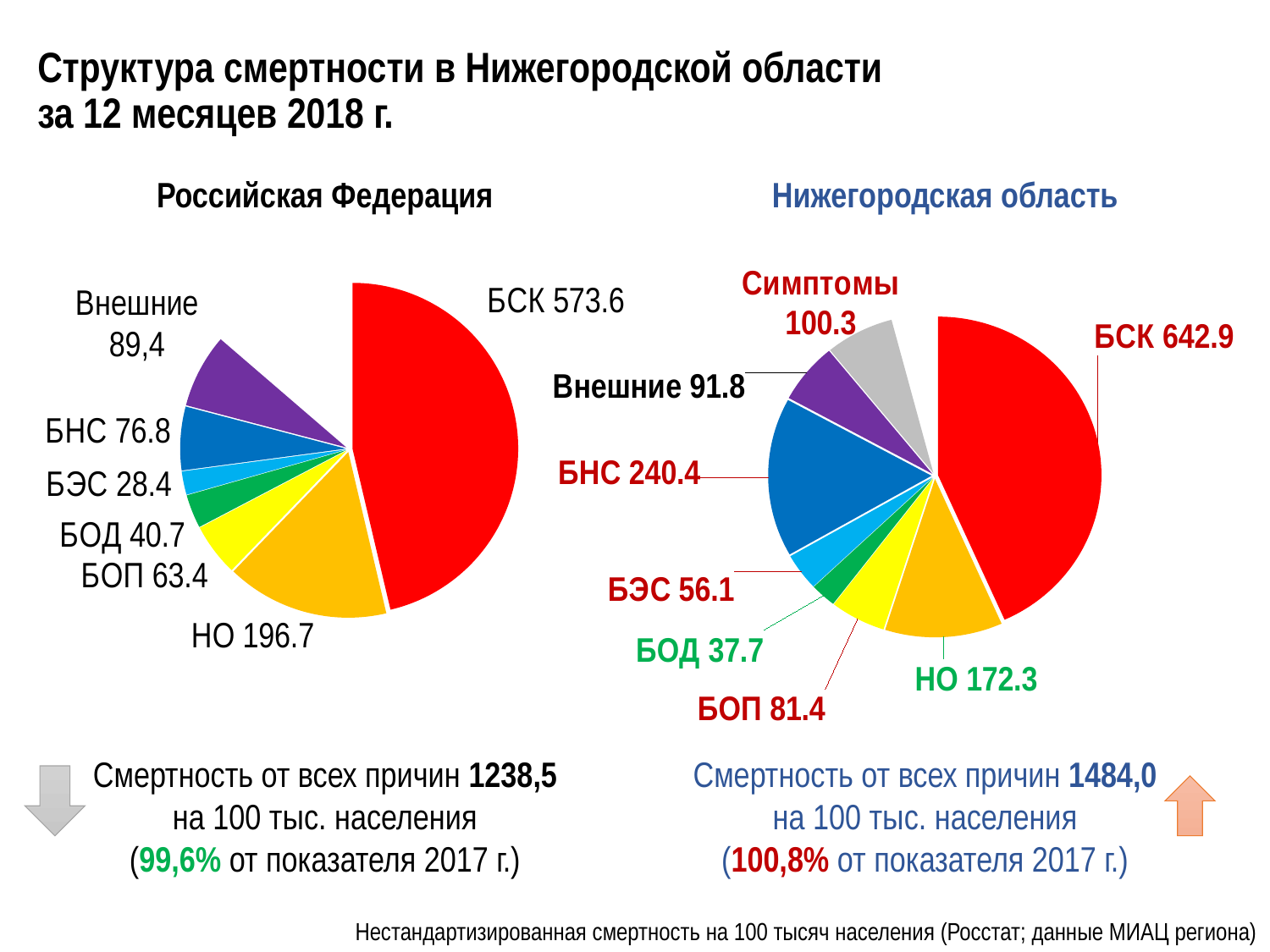
How many slices does the Нижегородская область pie chart have? 8 In the Нижегородская область pie chart, what is the value for БНС? 240.4 What is the difference between the БСК value in the Нижегородская область chart and the БСК value in the Российская Федерация chart? 69.3 Which category appears in the Нижегородская область pie chart but not in the Российская Федерация pie chart? Симптомы In the Нижегородская область pie chart, what is the value for Симптомы? 100.3 How many slices does the Российская Федерация pie chart have? 7 Which is larger: the НО value in the Российская Федерация chart or the НО value in the Нижегородская область chart? Российская Федерация In the Российская Федерация pie chart, which category has the smallest value? БЭС In the Российская Федерация pie chart, which category has the largest value? БСК In the Нижегородская область pie chart, which category has the smallest value? БОД In the Российская Федерация pie chart, what is the value for БСК? 573.6 What type of chart is used on the slide for the Российская Федерация data? pie chart